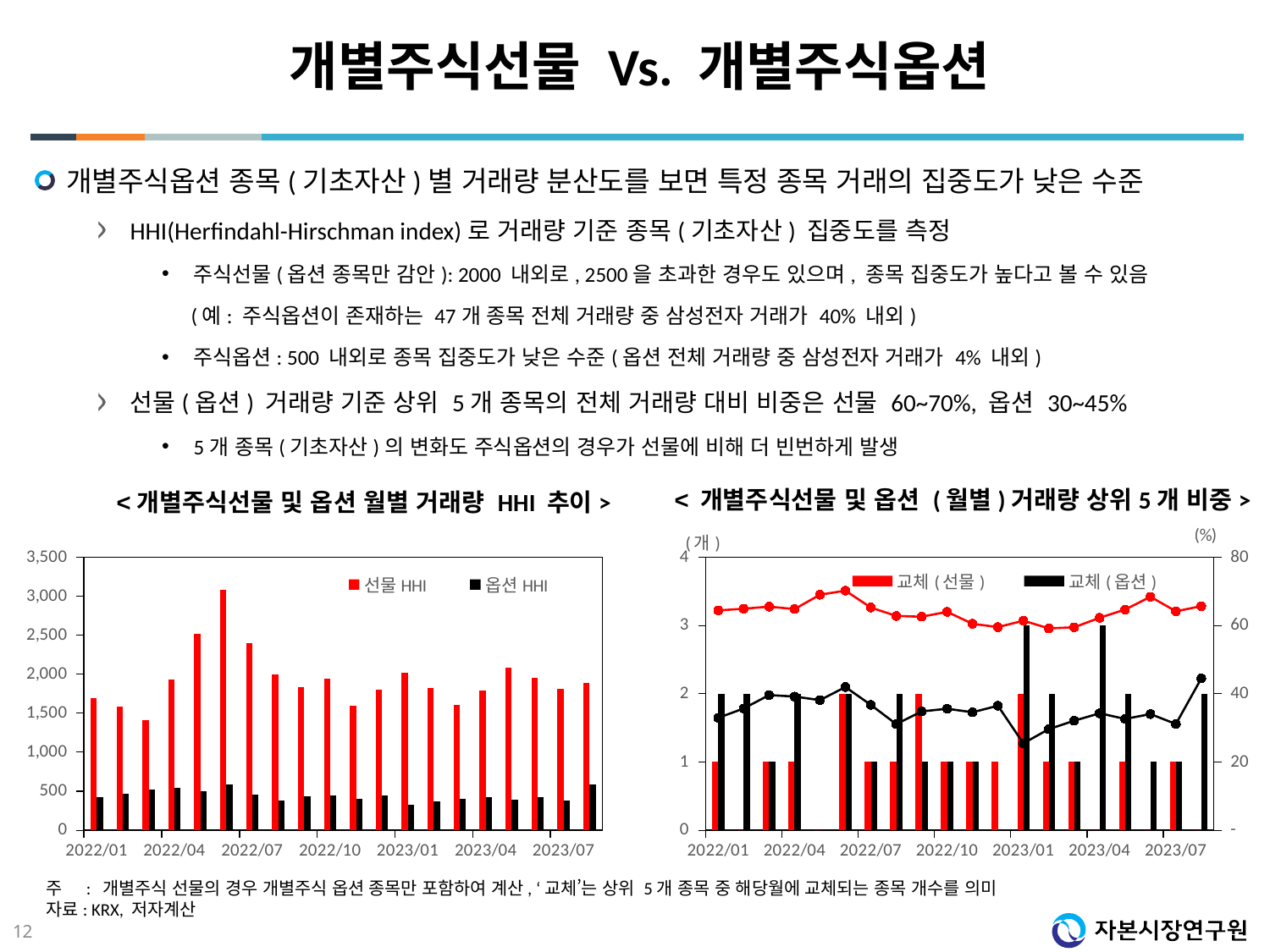
In the right chart (거래량 상위 5개 비중), what is the value of 교체(옵션) for 2022/01? 2 In the right chart (거래량 상위 5개 비중), how many series does the legend list? 2 What kind of chart is the left chart titled '개별주식선물 및 옵션 월별 거래량 HHI 추이'? bar chart In the left chart (HHI 추이), what are the two legend entries? 선물 HHI, 옵션 HHI In the right chart (거래량 상위 5개 비중), what is the highest value reached by the 교체(옵션) bars? 3 In the left chart (HHI 추이), is the 옵션 HHI value for 2022/01 greater or less than 1,000? less In the left chart (HHI 추이), which series is larger for 2022/01, 선물 HHI or 옵션 HHI? 선물 HHI In the right chart (거래량 상위 5개 비중), what unit is shown on the right-hand axis? (%) In the right chart (거래량 상위 5개 비중), what is the value of 교체(선물) for 2022/01? 1 In the left chart (HHI 추이), is the highest 선물 HHI value greater or less than 3,000? greater In the left chart (HHI 추이), is the 선물 HHI value for 2022/01 greater or less than 1,500? greater In the left chart (HHI 추이), how many series does the legend list? 2